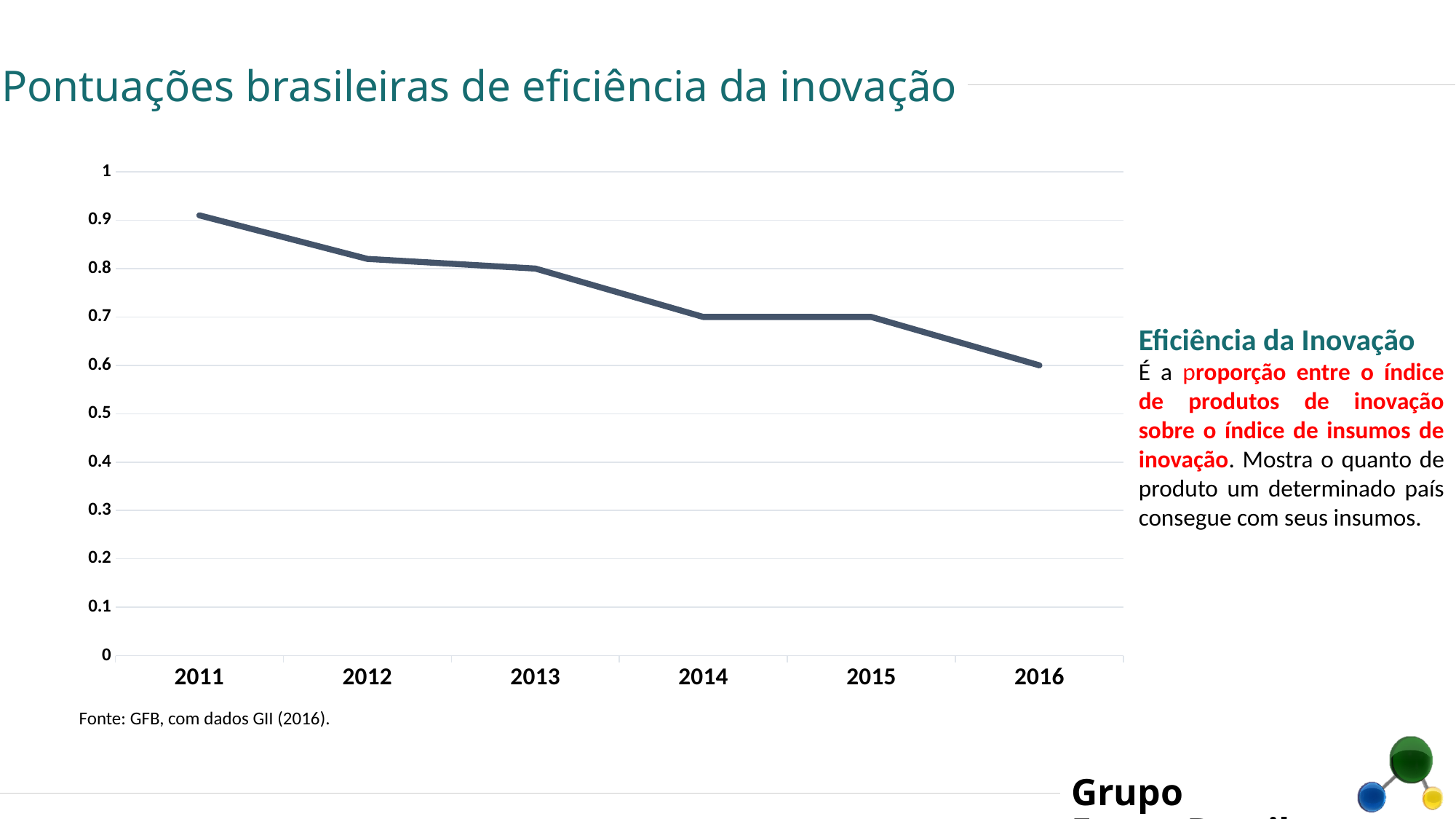
Do the values rise or fall from 2011 to 2016? fall Which year has the highest innovation efficiency score? 2011 Is the value for 2012 greater or less than 0.9? less What is the title of the chart? Pontuações brasileiras de eficiência da inovação Which year has the lowest innovation efficiency score? 2016 What kind of chart is shown on the slide? line chart Is the value for 2011 greater or less than 0.8? greater What is the value for 2013? 0.8 What is the difference between the values for 2013 and 2016? 0.2 What is the value for 2014? 0.7 How many years are plotted on the x axis? 6 What is the value for 2016? 0.6